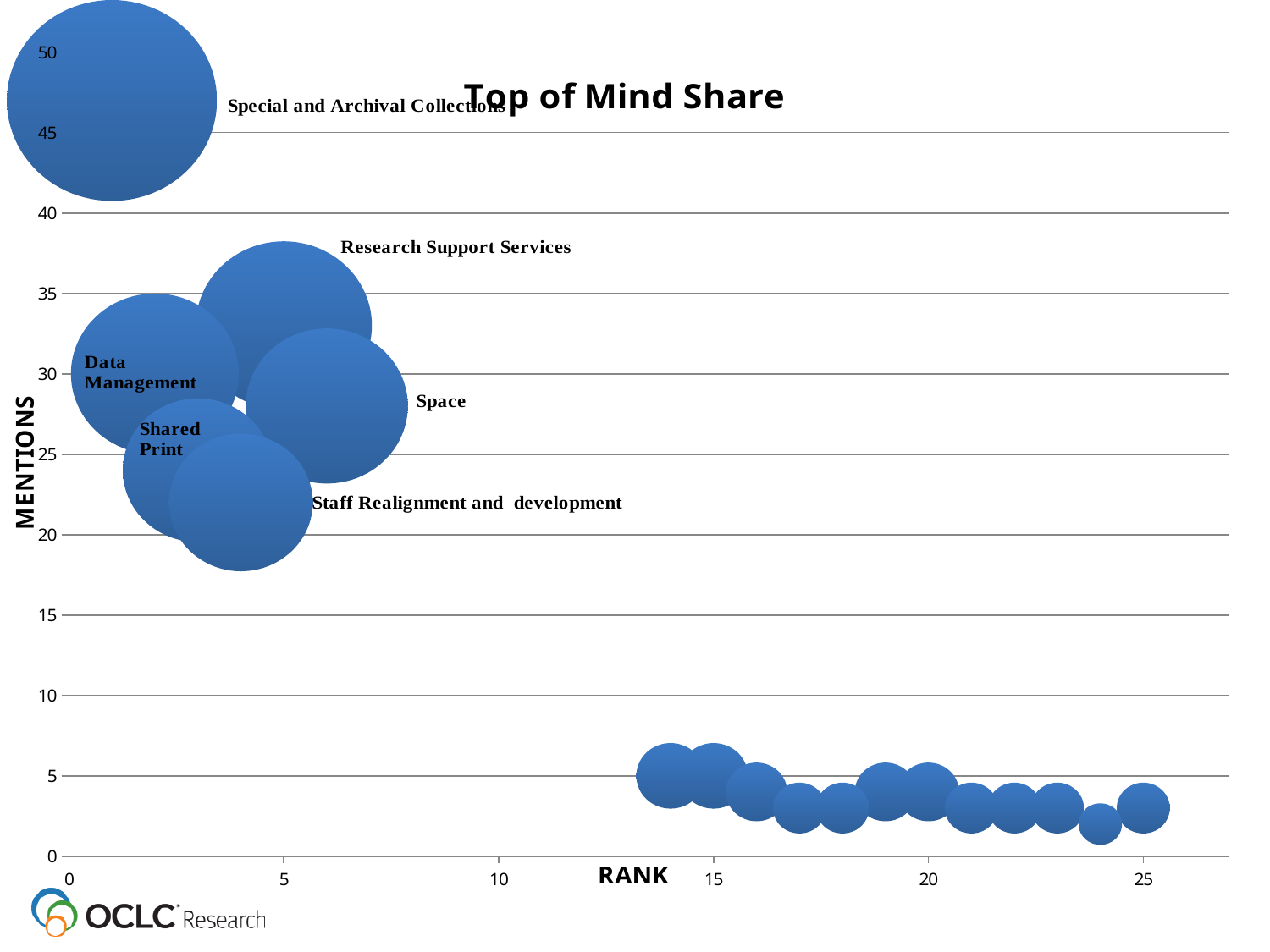
Is the number of mentions for Staff Realignment and development greater or less than 25? less What kind of chart is shown on the slide? bubble chart Which labeled topic has the highest number of mentions? Special and Archival Collections What is the title of the chart? Top of Mind Share How many bubbles on the chart have a text label naming the topic? 6 Which labeled topic has the lowest number of mentions? Staff Realignment and development Is the number of mentions for Research Support Services greater or less than 30? greater Which has more mentions, Research Support Services or Space? Research Support Services Do mentions rise or fall as rank increases along the x axis? fall What is the label on the vertical axis of the chart? MENTIONS Is the number of mentions for Space greater or less than 20? greater